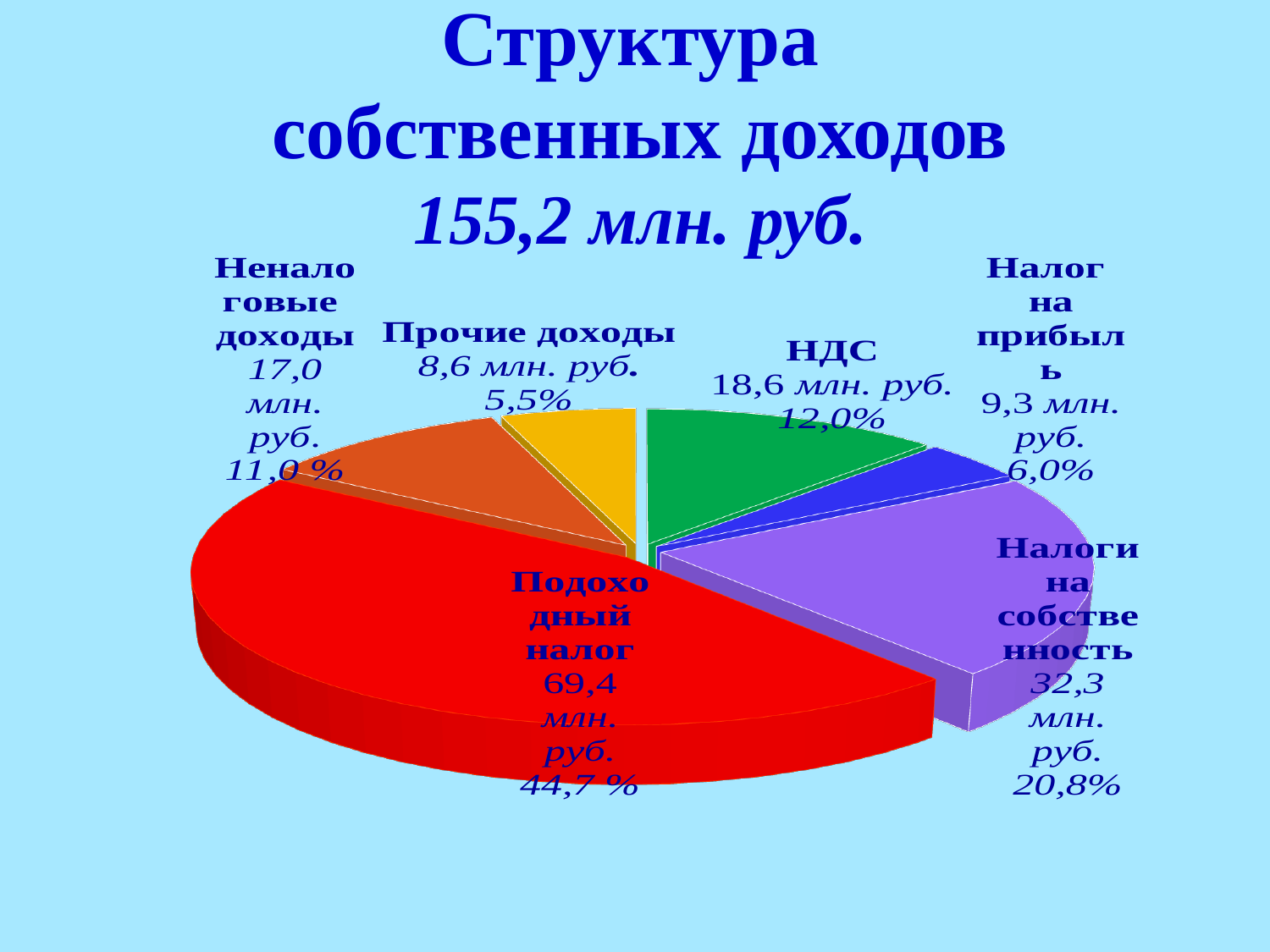
How many slices does the pie chart have? 6 Which category has the largest slice of the pie? Подоходный налог What share of the pie does Налог на прибыль represent? 6,0% What share of the pie does Налоги на собственность represent? 20,8% What is the difference in млн. руб. between Налоги на собственность and НДС? 13,7 млн. руб. What is the value for Неналоговые доходы in млн. руб.? 17,0 млн. руб. What is the value for НДС in млн. руб.? 18,6 млн. руб. What is the value for Подоходный налог in млн. руб.? 69,4 млн. руб. Which category has the smallest slice of the pie? Прочие доходы What share of the pie does Прочие доходы represent? 5,5% Which is larger, НДС or Налог на прибыль? НДС What kind of chart is shown on the slide? Pie chart